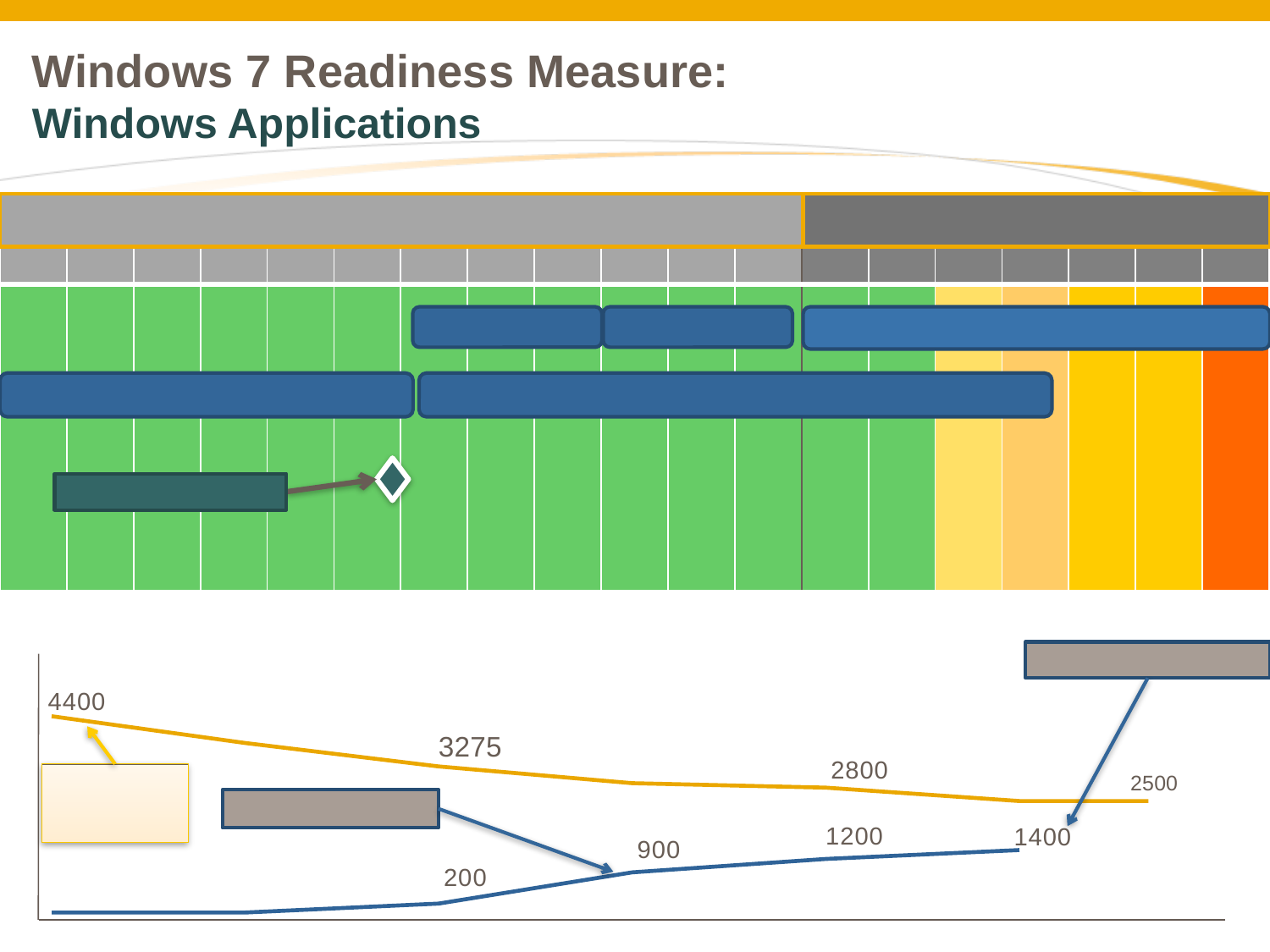
In the line chart at the bottom of the slide, what is the last labeled value on the orange line? 2500 In the line chart at the bottom of the slide, do the values on the orange line rise or fall from left to right? fall In the line chart at the bottom of the slide, what is the last labeled value on the blue line? 1400 In the line chart at the bottom of the slide, what is the highest labeled value on the orange line? 4400 What kind of chart is shown at the bottom of the slide? line chart In the line chart at the bottom of the slide, what is the difference between the last labeled value on the blue line (1400) and its first labeled value (200)? 1200 In the line chart at the bottom of the slide, what is the difference between the first labeled value on the orange line (4400) and its last labeled value (2500)? 1900 In the line chart at the bottom of the slide, what is the first labeled value on the blue line? 200 In the line chart at the bottom of the slide, do the values on the blue line rise or fall from left to right? rise In the line chart at the bottom of the slide, which is larger: the orange line's value of 3275 or the blue line's value of 900? 3275 (orange line) In the line chart at the bottom of the slide, what is the first labeled value on the orange line? 4400 In the line chart at the bottom of the slide, how many data labels are printed on the blue line? 4